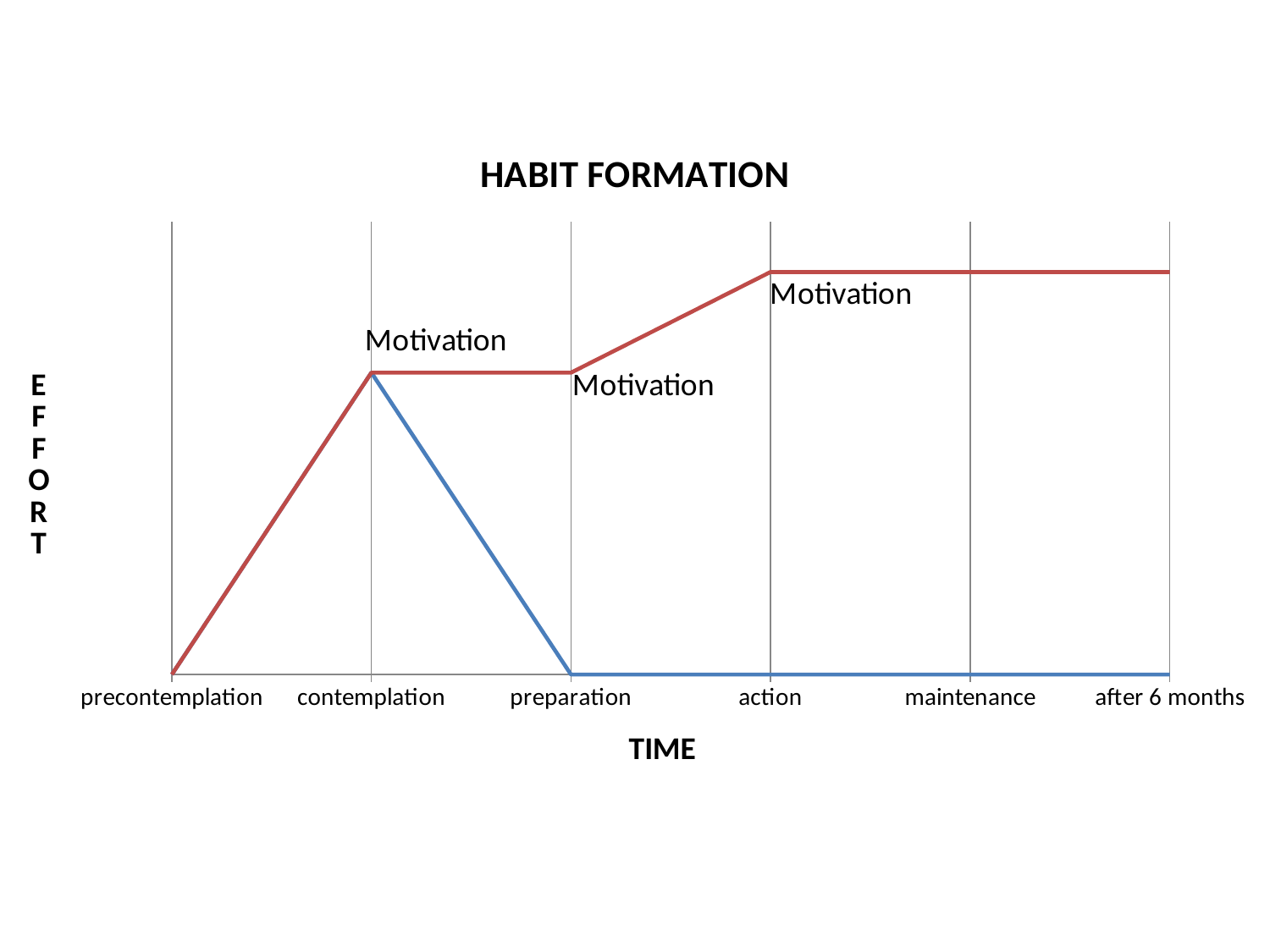
What kind of chart is shown on the slide? line chart Does the red line rise, fall or stay flat between action and after 6 months? stay flat Does the red line rise or fall between precontemplation and contemplation? rise How many lines are plotted on the chart? 2 At which category is the red line at its lowest? precontemplation How many categories are shown along the x axis? 6 Does the red line rise or fall between preparation and action? rise At which category is the blue line at its highest? contemplation What is the title of the chart? HABIT FORMATION What is the label on the vertical axis? EFFORT At action, which line is higher, the red line or the blue line? the red line